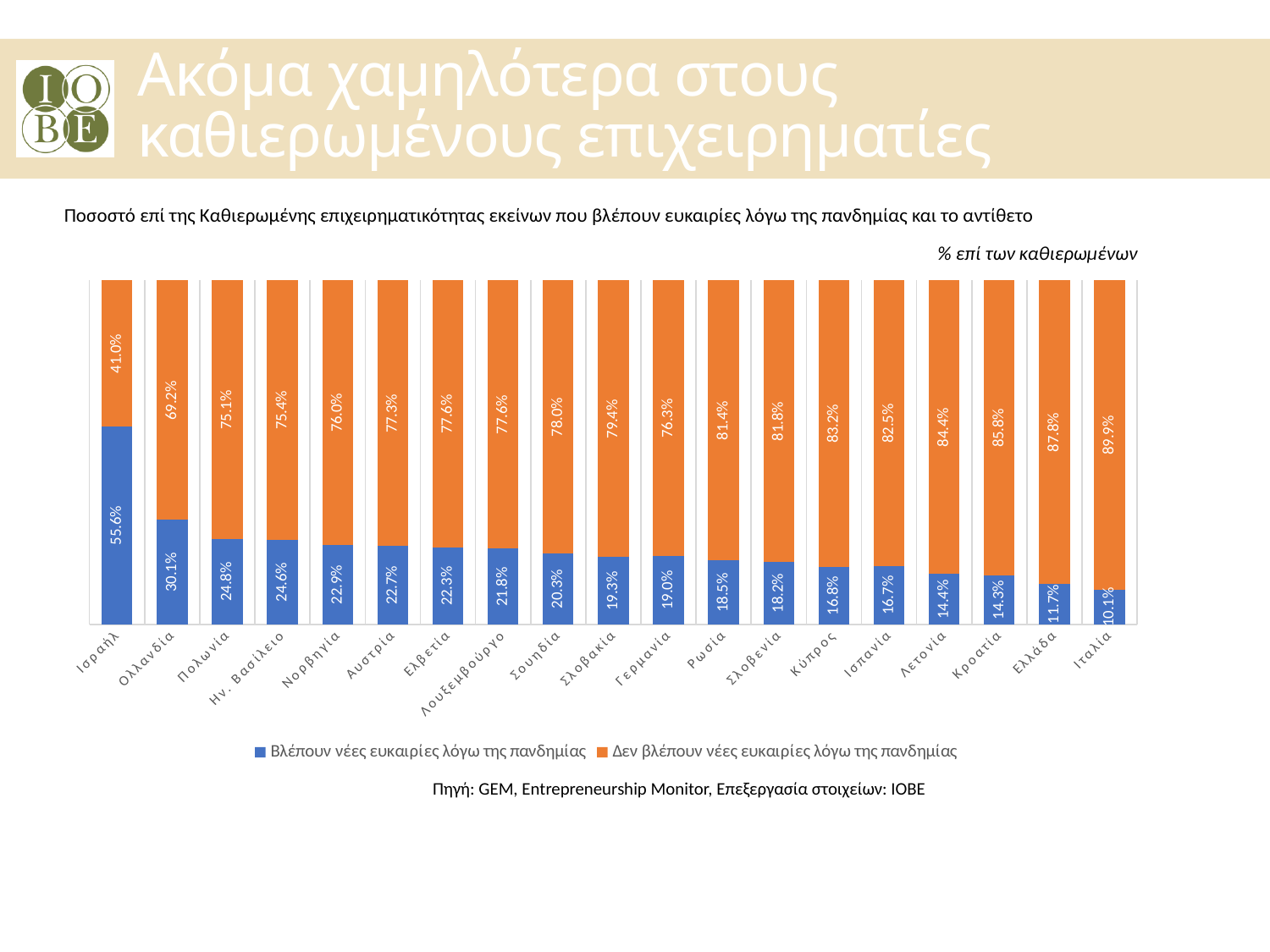
What is the value for Ιταλία in the series 'Δεν βλέπουν νέες ευκαιρίες λόγω της πανδημίας'? 89.9% What is the value for Γερμανία in the series 'Βλέπουν νέες ευκαιρίες λόγω της πανδημίας'? 19.0% Do the values of the series 'Βλέπουν νέες ευκαιρίες λόγω της πανδημίας' generally rise or fall from left to right along the x axis? Fall Which country has the lowest value in the series 'Δεν βλέπουν νέες ευκαιρίες λόγω της πανδημίας'? Ισραήλ Which country has the lowest value in the series 'Βλέπουν νέες ευκαιρίες λόγω της πανδημίας'? Ιταλία How many countries are shown on the x axis of the chart? 19 Which country has the highest value in the series 'Βλέπουν νέες ευκαιρίες λόγω της πανδημίας'? Ισραήλ How many series does the chart legend list? 2 What is the difference in percentage points between Ισραήλ and Ιταλία in the series 'Βλέπουν νέες ευκαιρίες λόγω της πανδημίας'? 45.5 percentage points Which has a larger value in the series 'Βλέπουν νέες ευκαιρίες λόγω της πανδημίας': Ολλανδία or Ελλάδα? Ολλανδία What kind of chart is shown on the slide? Stacked bar chart What percentage of established entrepreneurs in Ισραήλ see new opportunities due to the pandemic (Βλέπουν νέες ευκαιρίες λόγω της πανδημίας)? 55.6%